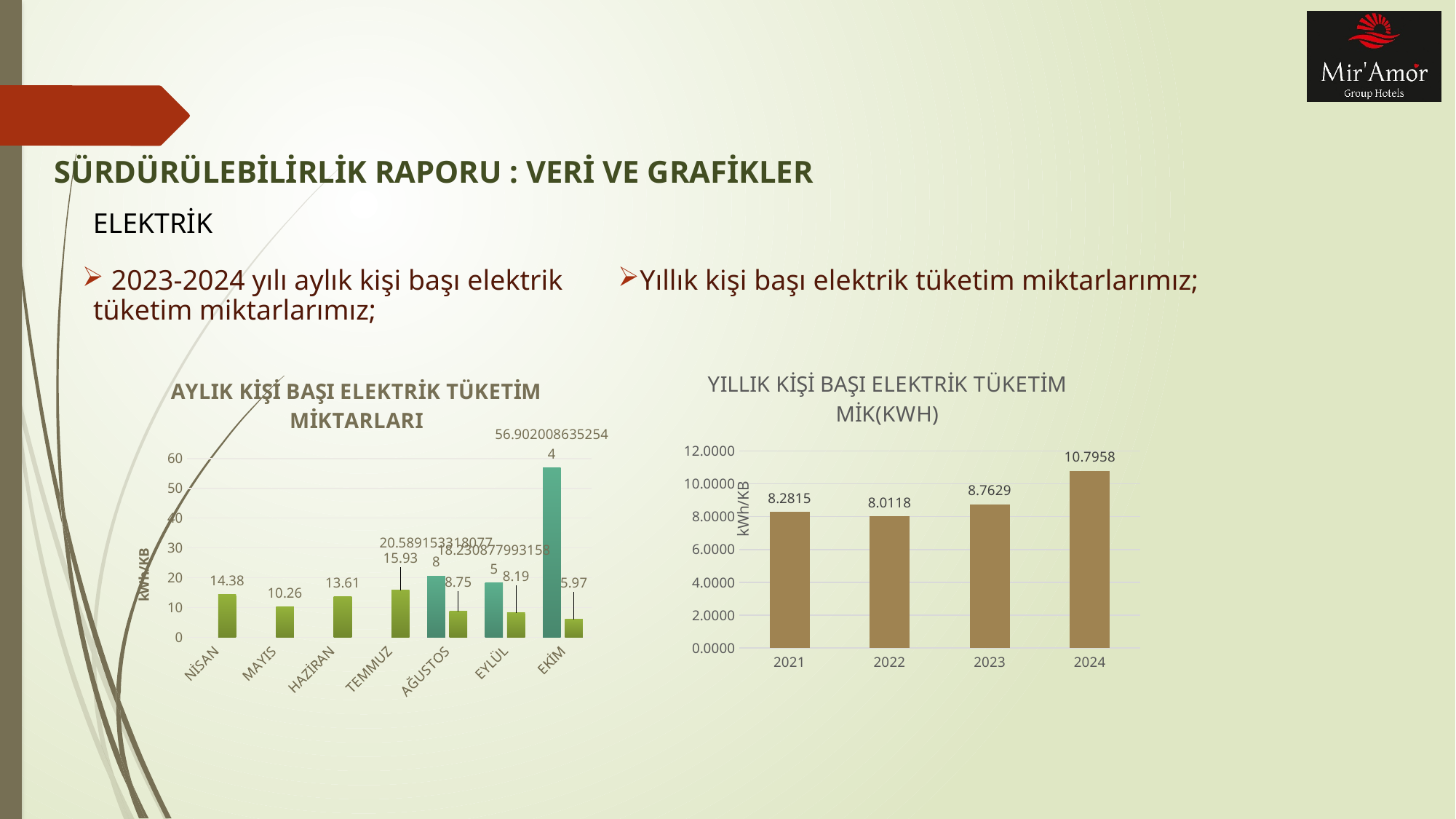
In the chart titled 'YILLIK KİŞİ BAŞI ELEKTRİK TÜKETİM MİK(KWH)', which year has the highest value? 2024 In the chart titled 'YILLIK KİŞİ BAŞI ELEKTRİK TÜKETİM MİK(KWH)', what is the value for 2021? 8.2815 In the chart titled 'YILLIK KİŞİ BAŞI ELEKTRİK TÜKETİM MİK(KWH)', is the value for 2024 greater or less than 10.0000? greater What kind of chart is the one titled 'YILLIK KİŞİ BAŞI ELEKTRİK TÜKETİM MİK(KWH)'? bar chart In the chart titled 'AYLIK KİŞİ BAŞI ELEKTRİK TÜKETİM MİKTARLARI', how many months are shown on the x axis? 7 In the chart titled 'YILLIK KİŞİ BAŞI ELEKTRİK TÜKETİM MİK(KWH)', what is the difference between the values for 2024 and 2023? 2.0329 In the chart titled 'YILLIK KİŞİ BAŞI ELEKTRİK TÜKETİM MİK(KWH)', how many years are shown on the x axis? 4 In the chart titled 'YILLIK KİŞİ BAŞI ELEKTRİK TÜKETİM MİK(KWH)', what is the value for 2024? 10.7958 In the chart titled 'YILLIK KİŞİ BAŞI ELEKTRİK TÜKETİM MİK(KWH)', which year has the lowest value? 2022 In the chart titled 'AYLIK KİŞİ BAŞI ELEKTRİK TÜKETİM MİKTARLARI', what is the value for MAYIS? 10.26 In the chart titled 'AYLIK KİŞİ BAŞI ELEKTRİK TÜKETİM MİKTARLARI', which is larger, the value for NİSAN or the value for HAZİRAN? NİSAN In the chart titled 'AYLIK KİŞİ BAŞI ELEKTRİK TÜKETİM MİKTARLARI', what is the value for NİSAN? 14.38